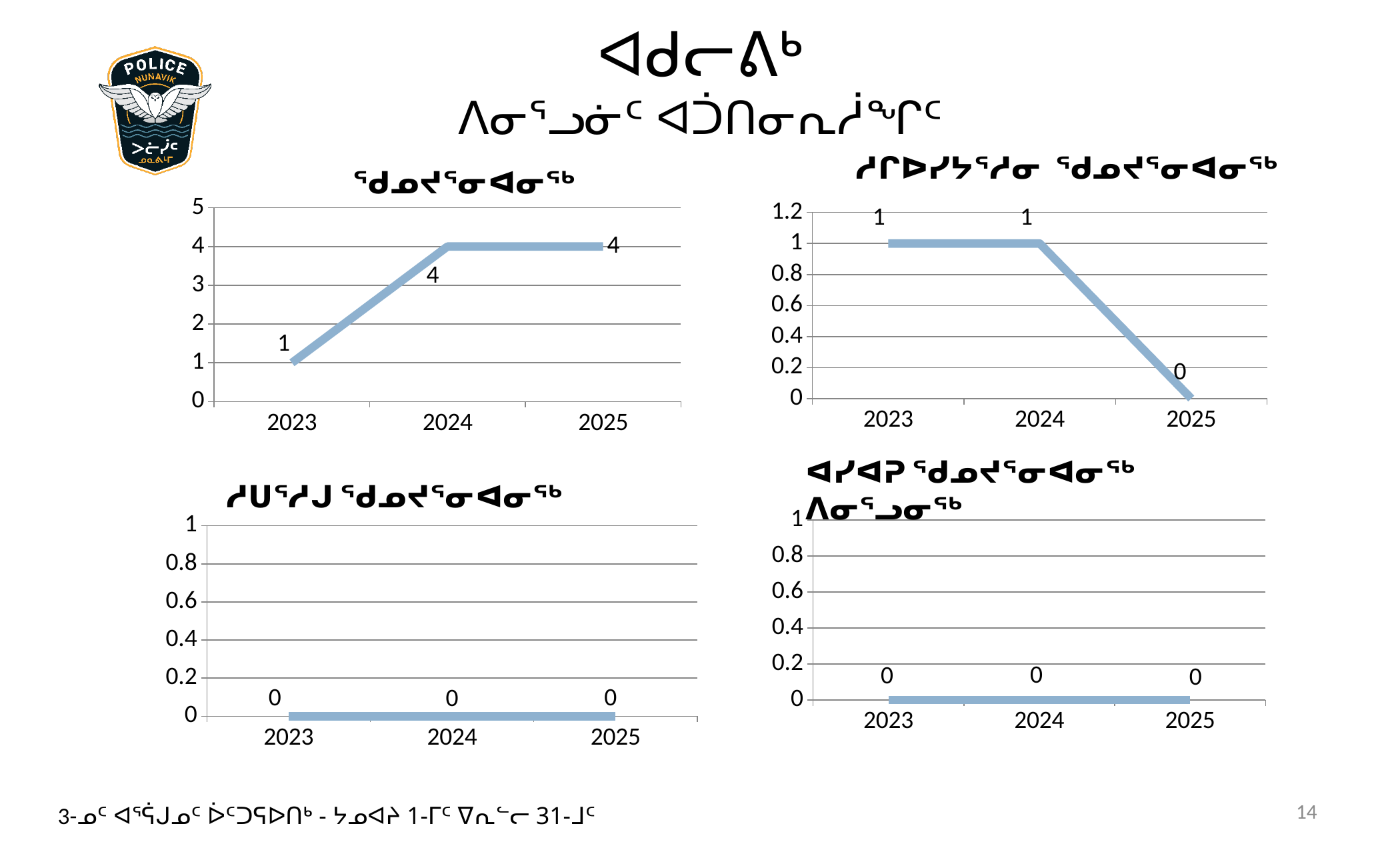
In the top-left chart, which year has the lowest value? 2023 In the top-left chart, what is the difference between the values for 2024 and 2023? 3 In the top-right chart, what is the value for 2025? 0 What kind of chart is the top-left chart? line chart How many years are plotted on the x axis of the bottom-left chart? 3 In the bottom-right chart, what is the value for 2025? 0 In the top-left chart, what is the value for 2024? 4 In the top-right chart, do the values rise or fall from 2024 to 2025? fall In the bottom-left chart, what is the value for 2024? 0 In the top-right chart, is the value for 2023 larger or smaller than the value for 2025? larger In the top-left chart, what is the value for 2023? 1 In the top-right chart, which year has the lowest value? 2025